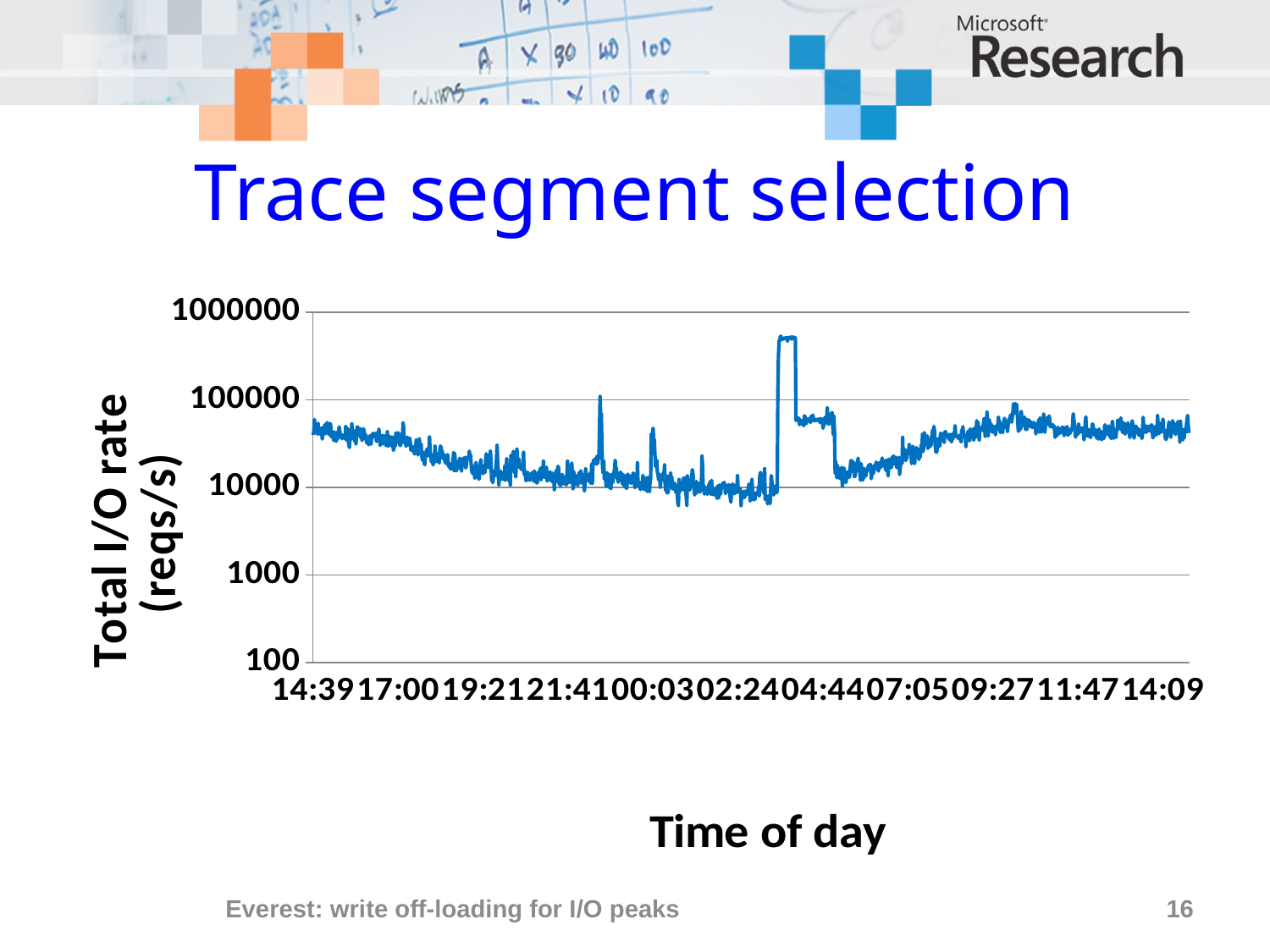
What kind of chart is shown on the slide? line chart What is the last time-of-day label on the x axis? 14:09 What is the first time-of-day label on the x axis? 14:39 Is the value of the line at 14:39 greater or less than 100000? less What is the label of the x axis? Time of day What is the label of the y axis? Total I/O rate (reqs/s) How many time-of-day tick labels are shown on the x axis? 11 Is the peak value of the line near 04:44 greater or less than 100000? greater Does the total I/O rate generally rise or fall between 14:39 and 02:24? fall Is the value of the line at 14:09 greater or less than 10000? greater What is the highest value shown on the y axis? 1000000 What is the lowest value shown on the y axis? 100